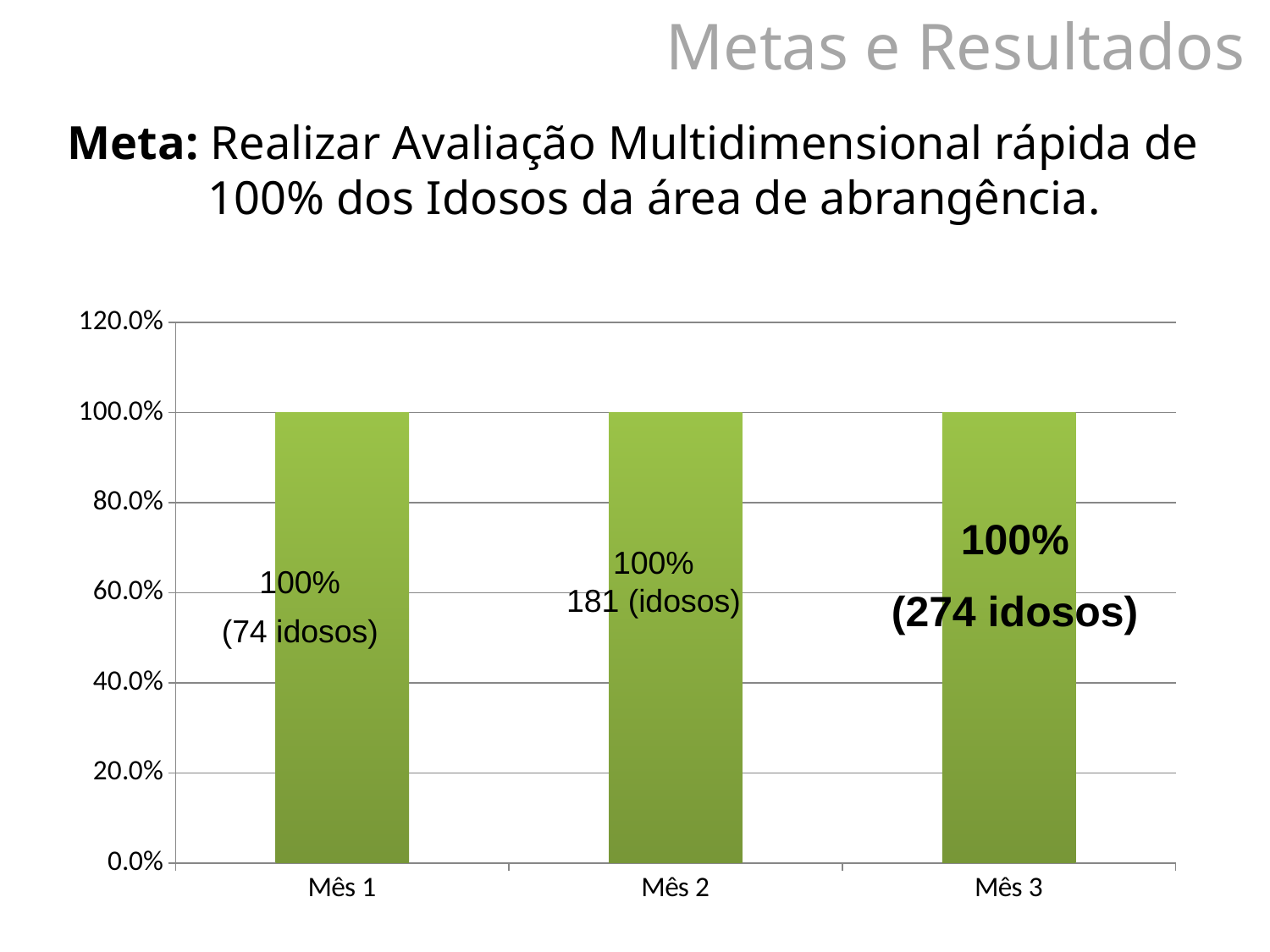
Do the values rise, fall, or stay the same from Mês 1 to Mês 3? Stay the same What is the value for Mês 3? 100% How many idosos are indicated in the label for Mês 2? 181 What is the difference between the values for Mês 2 and Mês 1? 0% What colour are the bars in the chart? Green What is the value for Mês 1? 100% How many idosos are indicated in the label for Mês 3? 274 How many idosos are indicated in the label for Mês 1? 74 How many categories are shown on the x axis? 3 What kind of chart is shown on the slide? Bar chart Is the value for Mês 2 greater or less than 80.0%? greater What is the highest value shown on the y axis? 120.0%